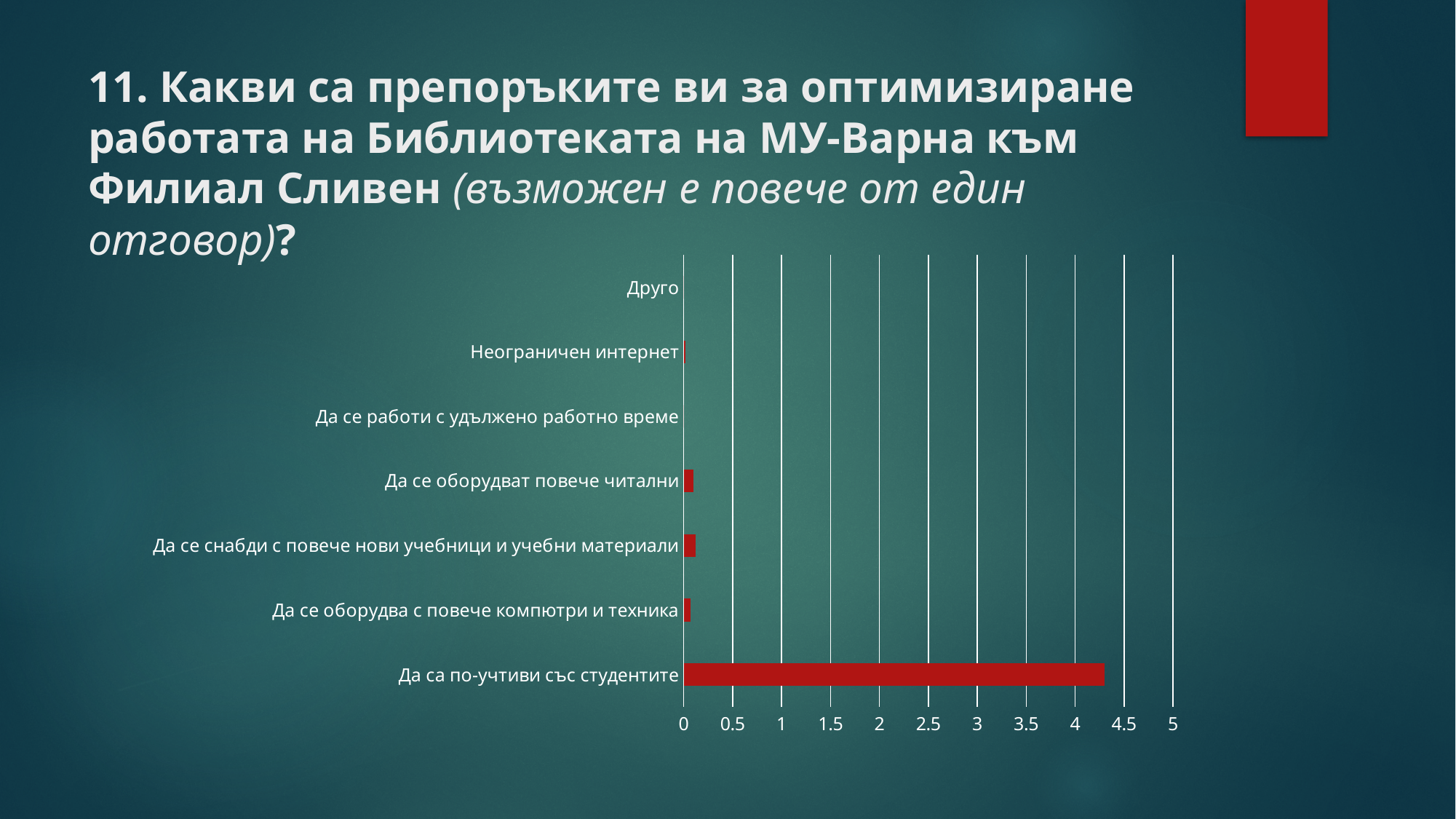
What is the highest value shown on the chart's horizontal axis? 5 What colour are the bars on the chart? red Which category has the highest value on the chart? Да са по-учтиви със студентите What kind of chart is shown on the slide? bar chart Is the value for "Да се оборудват повече читални" greater or less than 0.5? less Is the value for "Да са по-учтиви със студентите" greater or less than 4? greater How many categories are listed on the chart's vertical axis? 7 Which is larger: the value for "Да се оборудват повече читални" or the value for "Да са по-учтиви със студентите"? Да са по-учтиви със студентите Which is larger: the value for "Да са по-учтиви със студентите" or the value for "Да се оборудва с повече компютри и техника"? Да са по-учтиви със студентите Is the value for "Да са по-учтиви със студентите" greater or less than 4.5? less